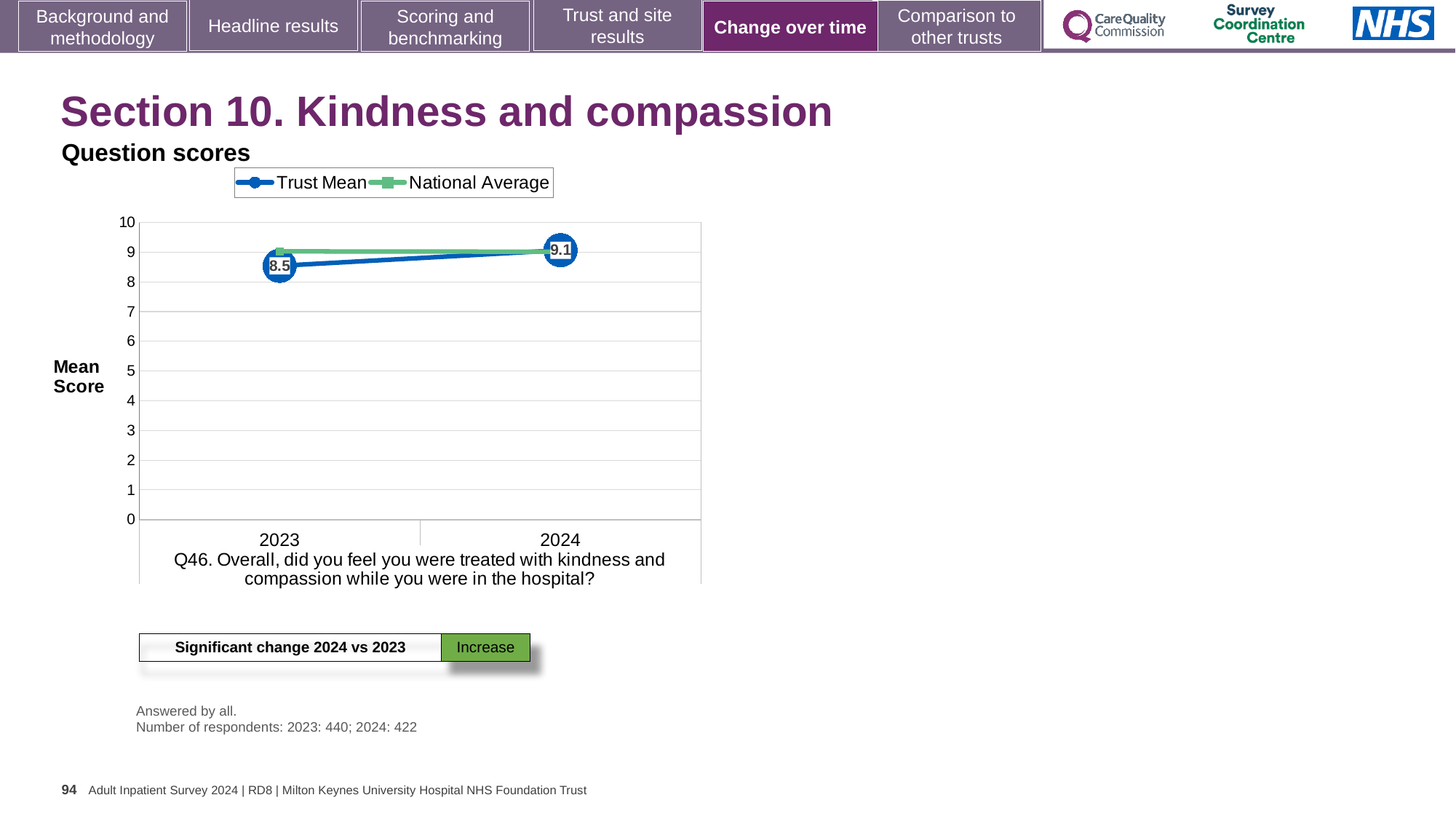
What is the Trust Mean score for 2023? 8.5 Which is larger, the Trust Mean score for 2023 or for 2024? 2024 In which year is the Trust Mean score lowest? 2023 In 2023, which is higher, the Trust Mean or the National Average? National Average What kind of chart is shown on the slide? Line chart What is the difference between the Trust Mean scores for 2024 and 2023? 0.6 Does the Trust Mean rise or fall from 2023 to 2024? Rise What is the Trust Mean score for 2024? 9.1 How many series does the chart legend list? 2 How many years are shown on the x axis of the chart? 2 Is the National Average value for 2023 greater or less than 8? greater In which year is the Trust Mean score highest? 2024